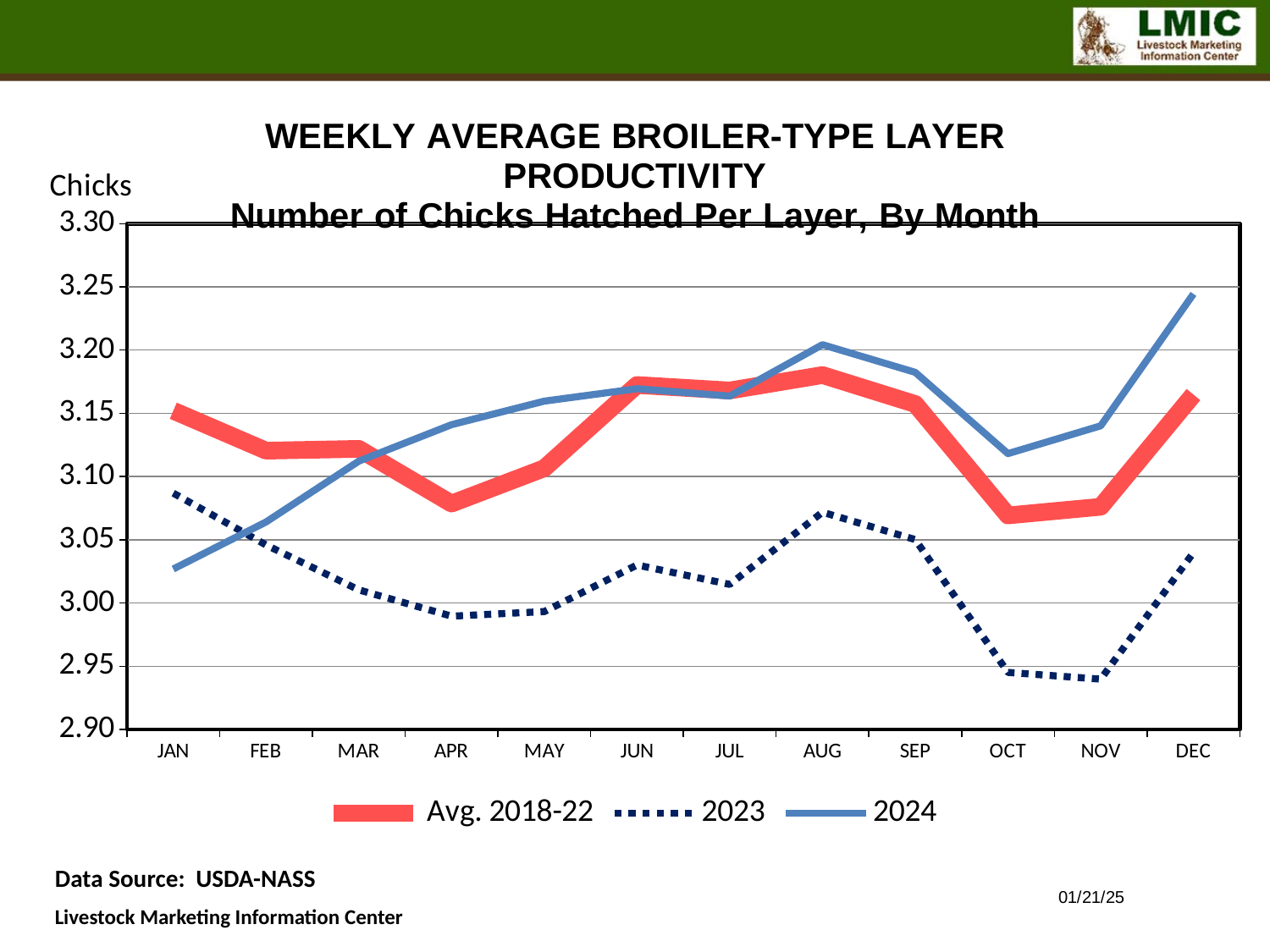
In which month does the 2024 series reach its highest value? DEC In JAN, which series has the higher value, Avg. 2018-22 or 2024? Avg. 2018-22 In DEC, which series has the higher value, 2023 or 2024? 2024 What kind of chart is shown on the slide? Line chart Is the 2024 value for JAN greater or less than 3.05? less Is the Avg. 2018-22 value for JAN greater or less than 3.10? greater Does the 2024 series rise or fall from JAN to JUN? rise How many months are shown along the x axis? 12 Is the 2024 value for DEC greater or less than 3.20? greater In which month is the 2024 series at its lowest value? JAN How many series does the legend list? 3 In which month does the 2023 series reach its highest value? JAN